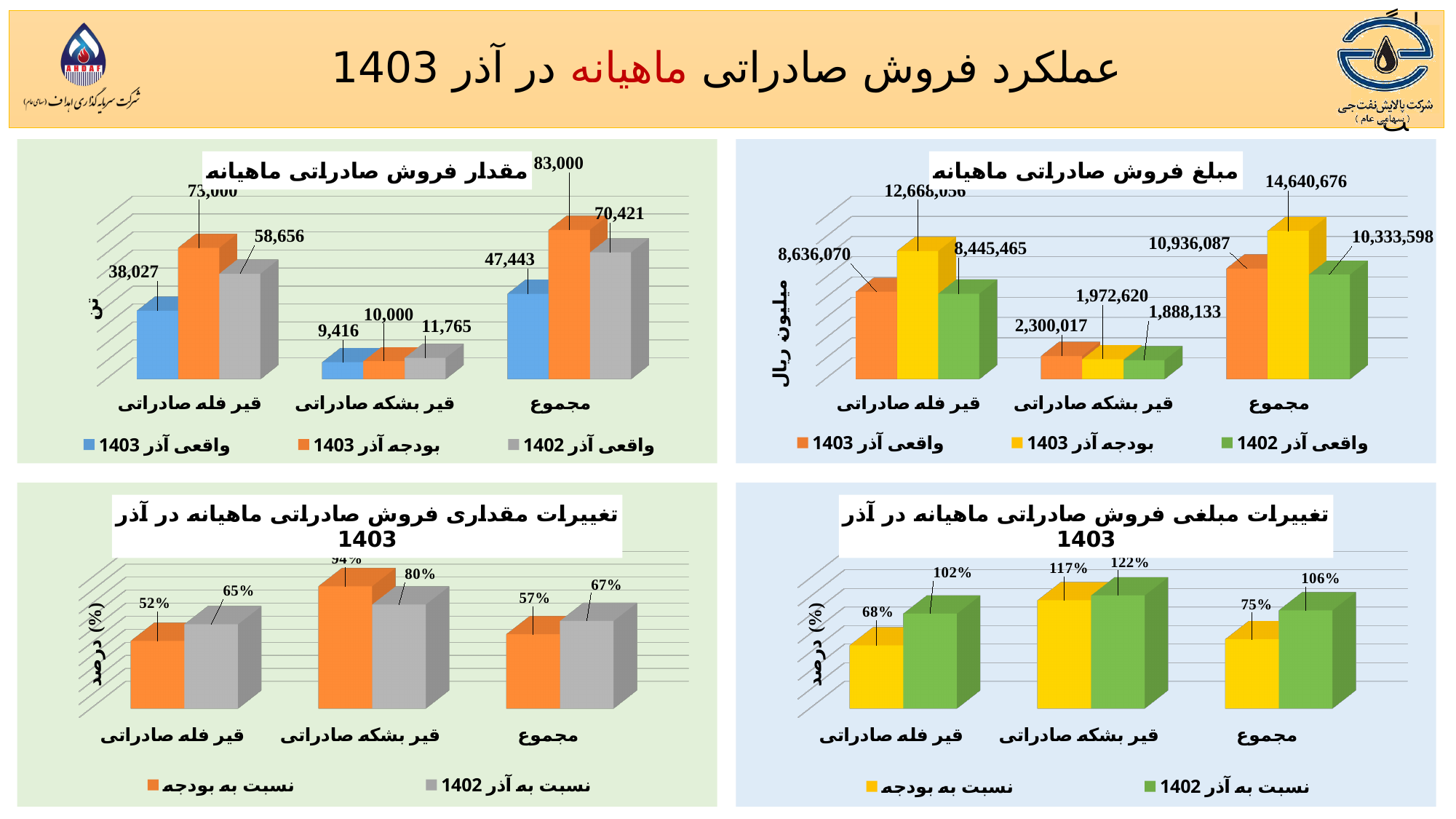
In the top-right chart (مبلغ فروش صادراتی ماهیانه), which series has the highest value for مجموع? بودجه آذر 1403 In the bottom-right chart (تغییرات مبلغی فروش صادراتی ماهیانه در آذر 1403), what is the value of نسبت به بودجه for قیر بشکه صادراتی? 117% How many series does the legend of the top-left chart (مقدار فروش صادراتی ماهیانه) list? 3 What kind of chart is the bottom-right chart (تغییرات مبلغی فروش صادراتی ماهیانه در آذر 1403)? Bar chart In the top-left chart (مقدار فروش صادراتی ماهیانه), what is the value of بودجه آذر 1403 for مجموع? 83,000 In the top-left chart (مقدار فروش صادراتی ماهیانه), what is the difference between بودجه آذر 1403 and واقعی آذر 1403 for قیر فله صادراتی? 34,973 In the top-right chart (مبلغ فروش صادراتی ماهیانه), what is the value of واقعی آذر 1403 for مجموع? 10,936,087 In the top-right chart (مبلغ فروش صادراتی ماهیانه), what is the value of واقعی آذر 1402 for قیر بشکه صادراتی? 1,888,133 In the bottom-left chart (تغییرات مقداری فروش صادراتی ماهیانه در آذر 1403), what is the value of نسبت به آذر 1402 for مجموع? 67% In the top-left chart (مقدار فروش صادراتی ماهیانه), which series has the lowest value for قیر بشکه صادراتی? واقعی آذر 1403 In the top-left chart (مقدار فروش صادراتی ماهیانه), what is the value of واقعی آذر 1403 for قیر فله صادراتی? 38,027 In the top-right chart (مبلغ فروش صادراتی ماهیانه), which is larger for قیر فله صادراتی: واقعی آذر 1403 or واقعی آذر 1402? واقعی آذر 1403